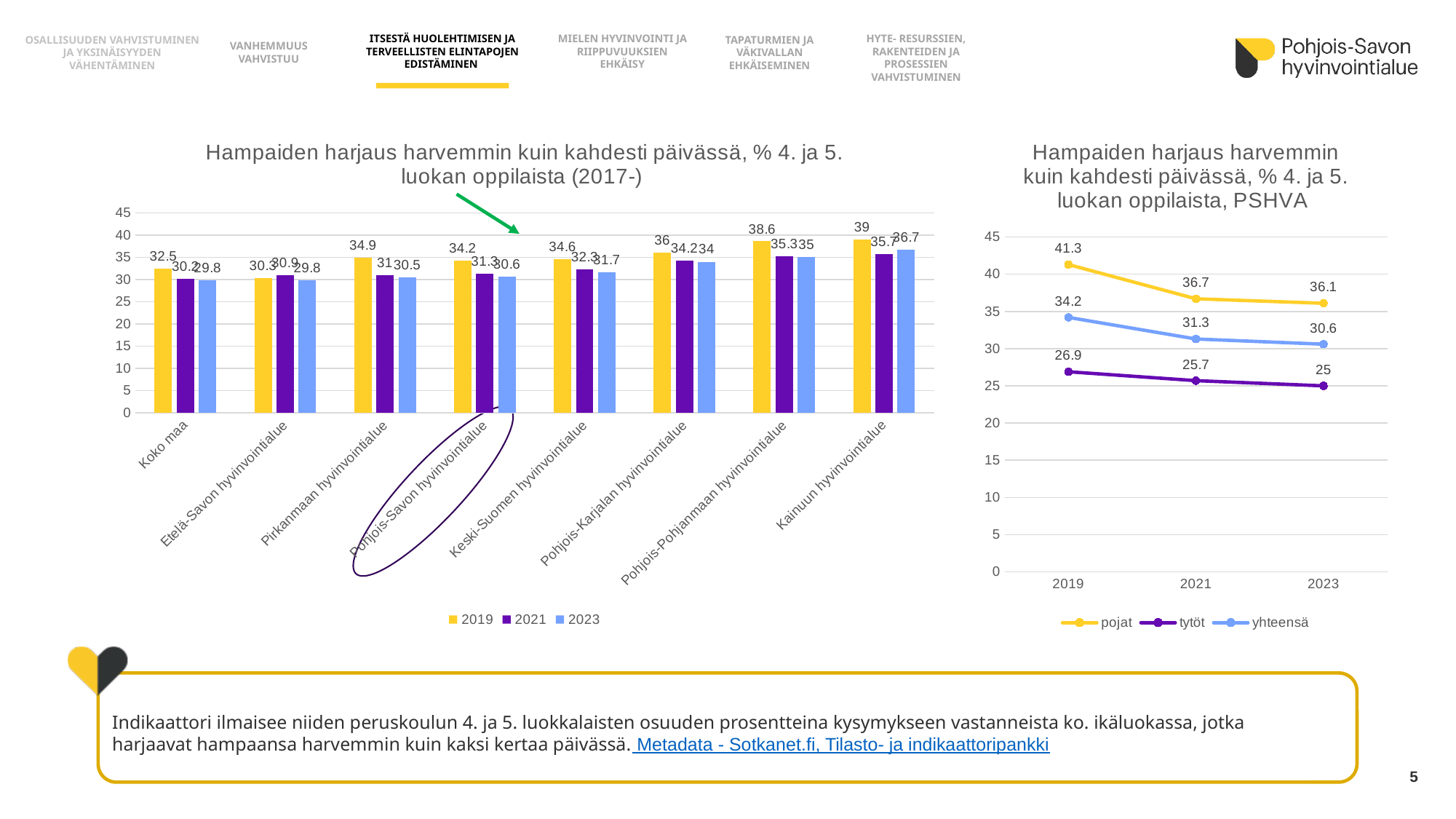
In the left bar chart, which region has the highest 2019 value? Kainuun hyvinvointialue In the left bar chart, which is larger: the 2019 value for Pirkanmaan hyvinvointialue or the 2019 value for Pohjois-Karjalan hyvinvointialue? Pohjois-Karjalan hyvinvointialue In the left bar chart, what is the 2019 value for Kainuun hyvinvointialue? 39 In the left bar chart, what is the difference between the 2019 and 2023 values for Pohjois-Savon hyvinvointialue? 3.6 In the right line chart (PSHVA), what is the value for pojat in 2019? 41.3 In the right line chart (PSHVA), what is the difference between pojat and tytöt in 2023? 11.1 In the left bar chart, what is the 2023 value for Pohjois-Savon hyvinvointialue? 30.6 In the left bar chart, how many regions (categories) are shown on the x axis? 8 What kind of chart is the chart on the right of the slide (PSHVA)? Line chart In the right line chart (PSHVA), does the tytöt series rise or fall from 2019 to 2023? Fall In the left bar chart, how many series does the legend list? 3 In the right line chart (PSHVA), which series has the lowest value in 2021? tytöt